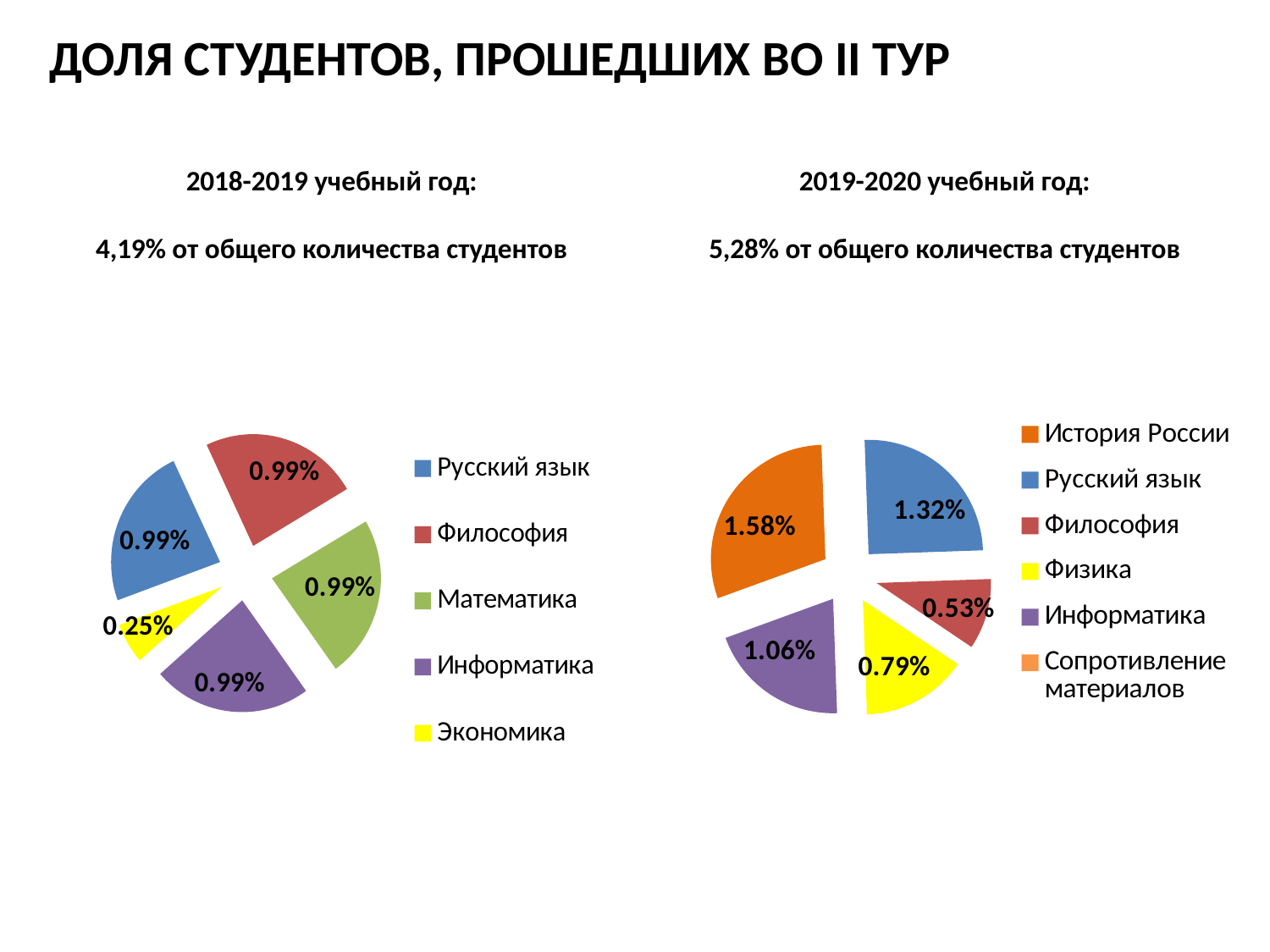
In the 2019-2020 chart, what is the value for Физика? 0.79% What type of chart is used for the 2018-2019 academic year? Pie chart In the 2018-2019 chart, what is the value for Математика? 0.99% In the 2019-2020 chart, what is the value for Философия? 0.53% How many entries does the legend of the 2019-2020 chart list? 6 In the 2019-2020 chart, which category has the lowest labelled value? Философия In the 2019-2020 chart, which category has the highest value? История России In the 2019-2020 chart, what is the value for История России? 1.58% In the 2018-2019 chart, what is the value for Экономика? 0.25% In the 2019-2020 chart, which is larger, the value for Информатика or the value for Физика? Информатика In the 2019-2020 chart, what is the difference between the values for История России and Русский язык? 0.26% In the 2018-2019 chart, which category has the lowest value? Экономика